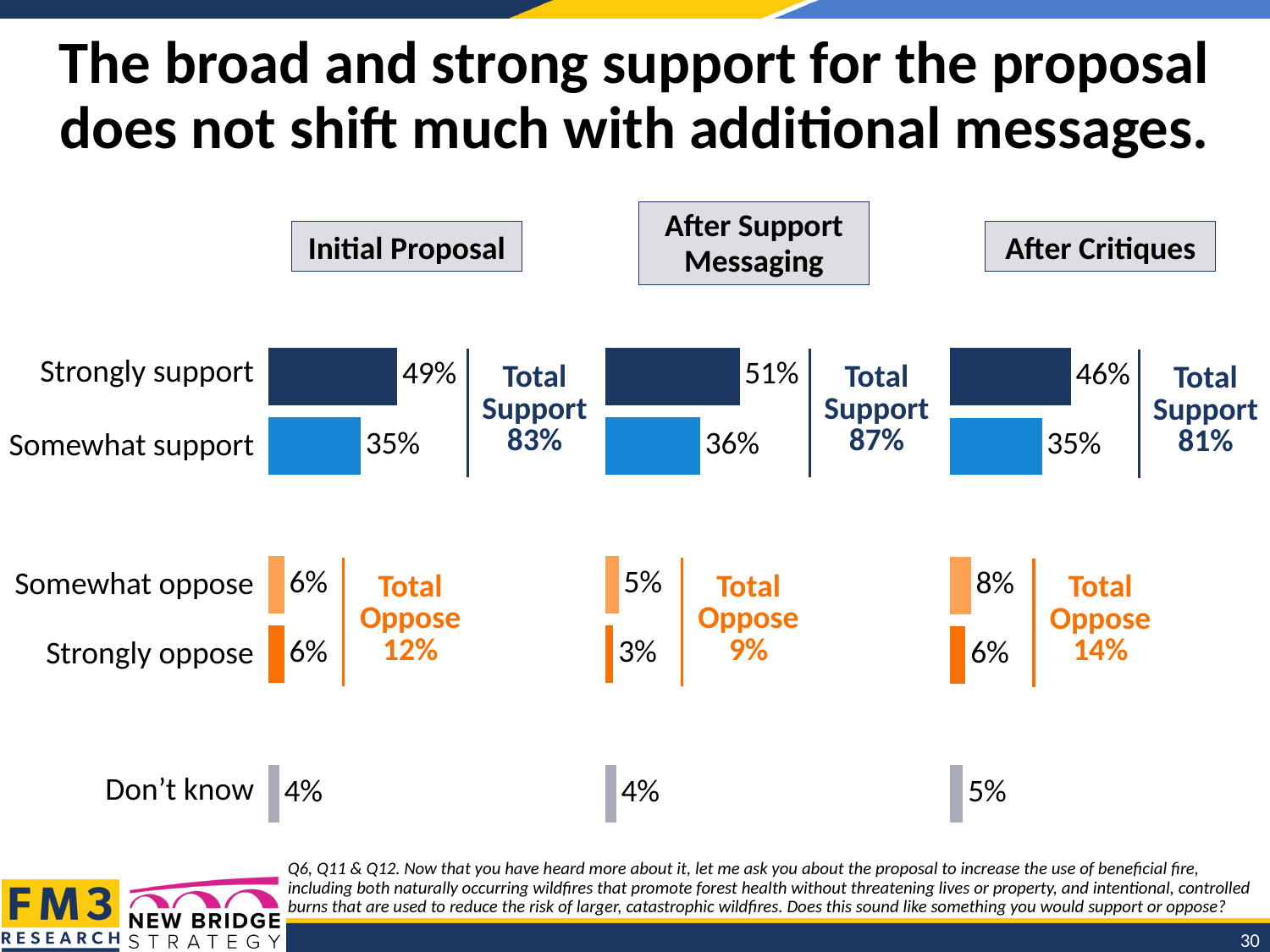
In the After Support Messaging chart, what percentage somewhat support the proposal? 36% In the After Critiques chart, what percentage somewhat oppose the proposal? 8% In the After Support Messaging chart, which category has the lowest value? Strongly oppose What is the Total Support shown for the After Support Messaging chart? 87% In the Initial Proposal chart, which category has the highest value? Strongly support In the Initial Proposal chart, what percentage strongly support the proposal? 49% Which is larger: Strongly support in the After Support Messaging chart or Strongly support in the After Critiques chart? After Support Messaging What is the Total Oppose shown for the After Critiques chart? 14% In the After Critiques chart, what is the Don't know percentage? 5% What type of chart is used to show the Initial Proposal results? Bar chart How many response categories are shown in the Initial Proposal chart? 5 In the After Critiques chart, what is the difference between Strongly support and Somewhat support? 11%